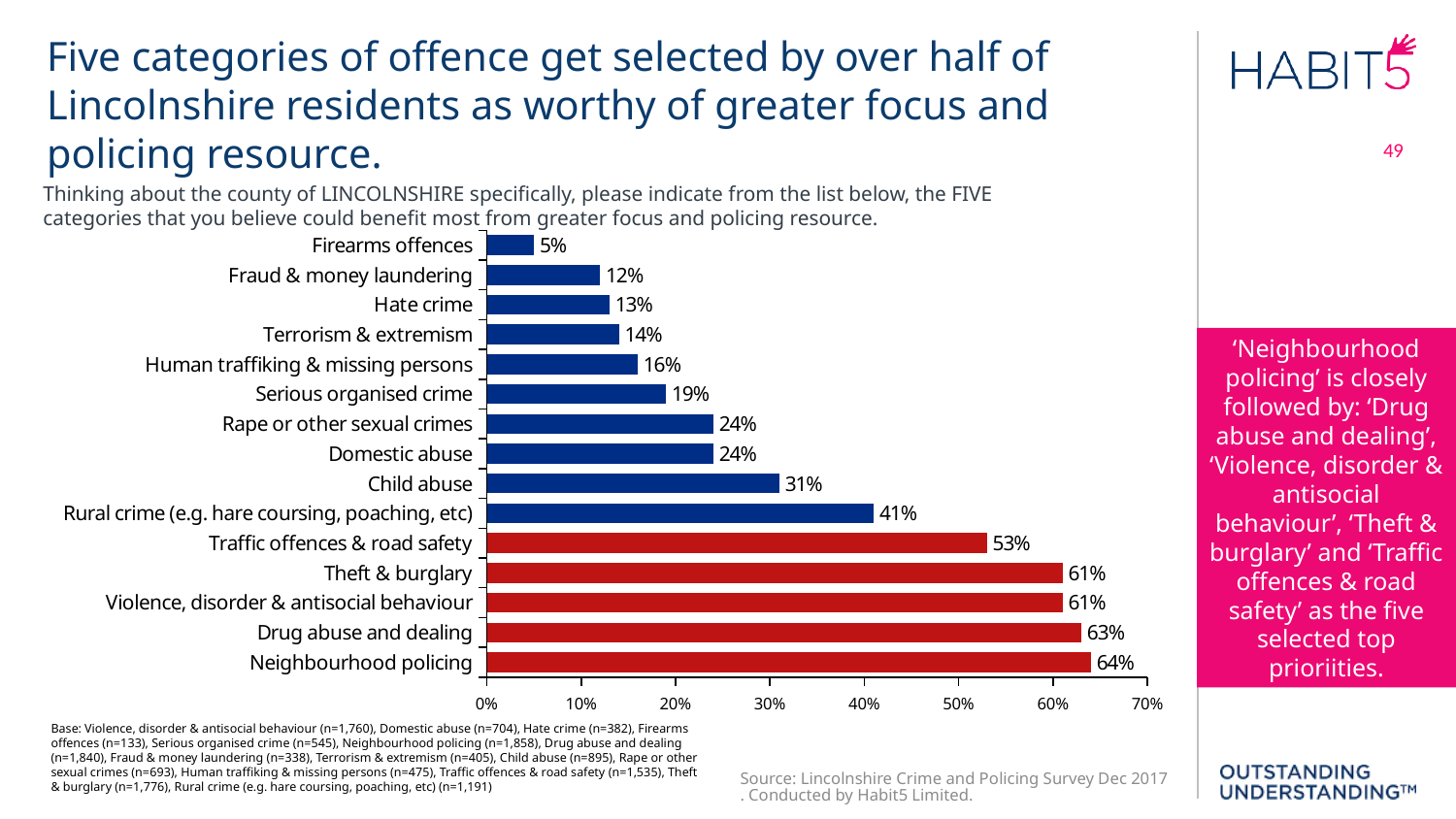
What is the difference in percentage points between Traffic offences & road safety and Child abuse? 22 How many categories are shown with red bars? 5 What percentage of Lincolnshire residents selected Neighbourhood policing? 64% What type of chart is shown on the slide? Bar chart What is the value shown for Rural crime (e.g. hare coursing, poaching, etc)? 41% Which category has the lowest percentage? Firearms offences Which is larger, the value for Serious organised crime or the value for Hate crime? Serious organised crime How many categories of offence are shown in the chart? 15 What percentage selected Firearms offences? 5% Which category has the highest percentage? Neighbourhood policing What is the difference in percentage points between Neighbourhood policing and Drug abuse and dealing? 1 Is the value for Child abuse greater or less than 30%? greater